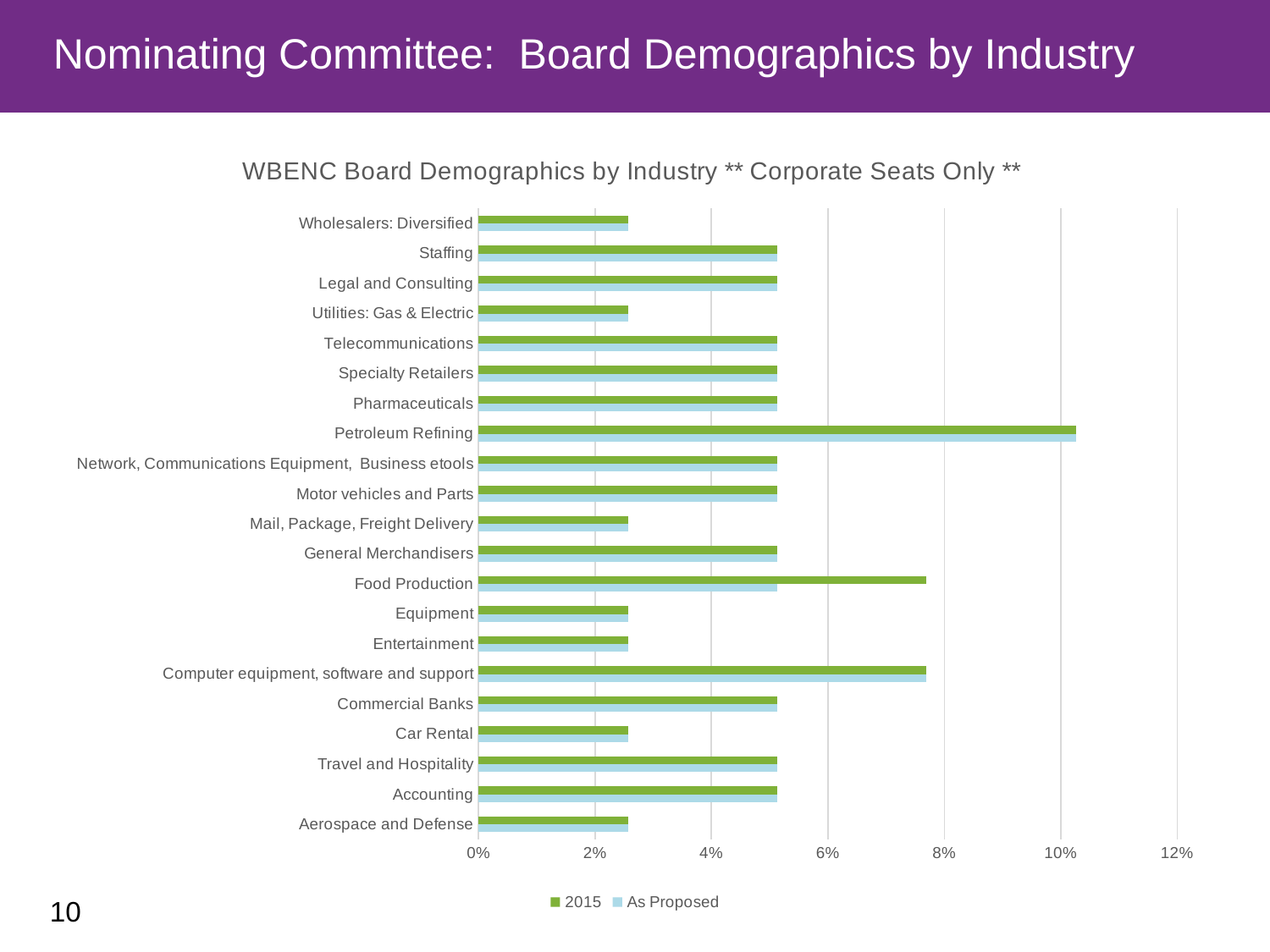
Is the 2015 value for Car Rental greater or less than 4%? less Which industry has the highest value for the As Proposed series? Petroleum Refining What is the title of the chart? WBENC Board Demographics by Industry ** Corporate Seats Only ** For Food Production, which series has the larger value, 2015 or As Proposed? 2015 What kind of chart is shown on the slide? Bar chart How many industry categories are plotted on the chart? 21 How many series does the legend list? 2 What are the two series named in the legend? 2015 and As Proposed Is the As Proposed value for Food Production greater or less than 6%? less Is the 2015 value for Petroleum Refining greater or less than 8%? greater Which industry has the highest value for the 2015 series? Petroleum Refining